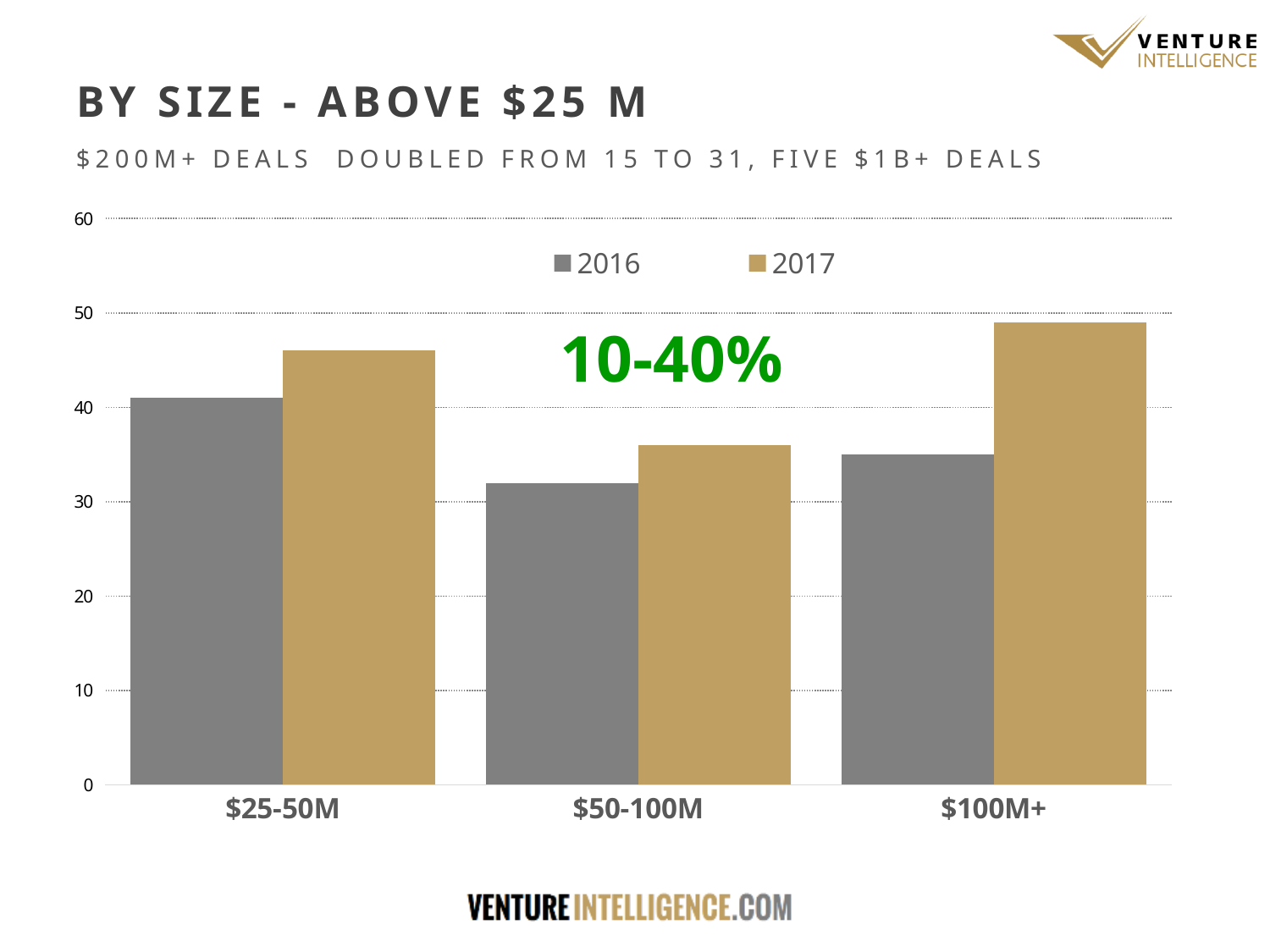
Which category has the lowest value for 2017? $50-100M Is the value for $25-50M in 2017 greater or less than 40? greater How many series does the legend list? 2 For the $25-50M category, which year has the larger value, 2016 or 2017? 2017 Which category has the highest value for 2016? $25-50M Is the value for $100M+ in 2016 greater or less than 40? less Is the value for $50-100M in 2017 greater or less than 40? less What kind of chart is shown on the slide? bar chart For the $100M+ category, which year has the larger value, 2016 or 2017? 2017 How many deal-size categories are shown on the x axis? 3 What is the title of the chart slide? BY SIZE - ABOVE $25 M